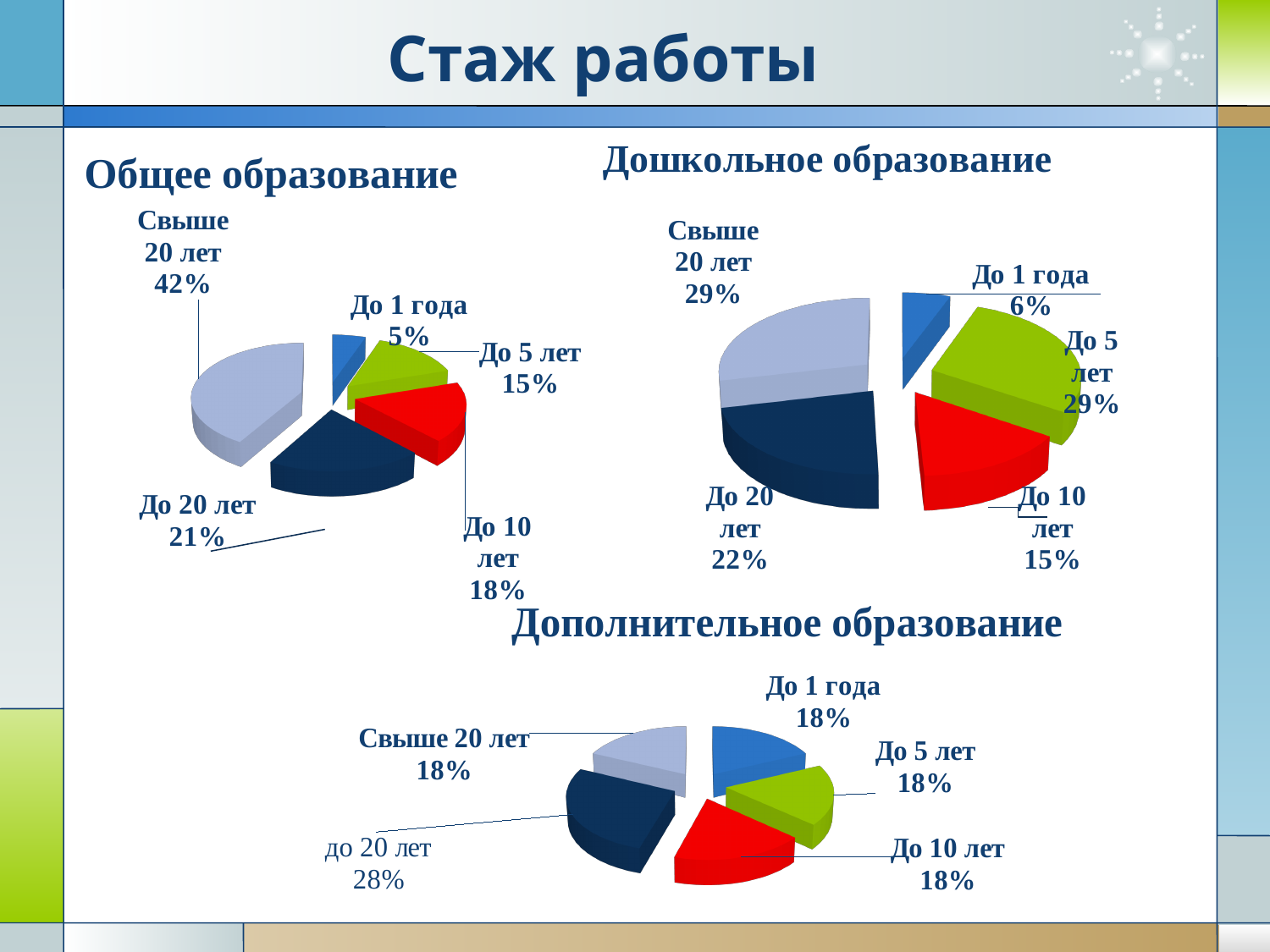
In the 'Дошкольное образование' chart, which is larger: the share for 'До 10 лет' or for 'До 20 лет'? До 20 лет In the 'Дополнительное образование' chart, which category has the largest share? до 20 лет In the 'Дошкольное образование' chart, what share is labelled for 'До 20 лет'? 22% In the 'Общее образование' chart, what share is labelled for 'Свыше 20 лет'? 42% In the 'Дошкольное образование' chart, which category has the smallest share? До 1 года In the 'Общее образование' chart, which category has the smallest share? До 1 года In the 'Общее образование' chart, what is the difference between the shares for 'До 20 лет' and 'До 10 лет'? 3% What type of chart is used for 'Дополнительное образование'? Pie chart How many slices does the 'Общее образование' pie chart have? 5 In the 'Дошкольное образование' chart, what is the difference between the shares for 'Свыше 20 лет' and 'До 10 лет'? 14% In the 'Дополнительное образование' chart, what share is labelled for 'До 5 лет'? 18% How many pie charts are shown on the slide? 3